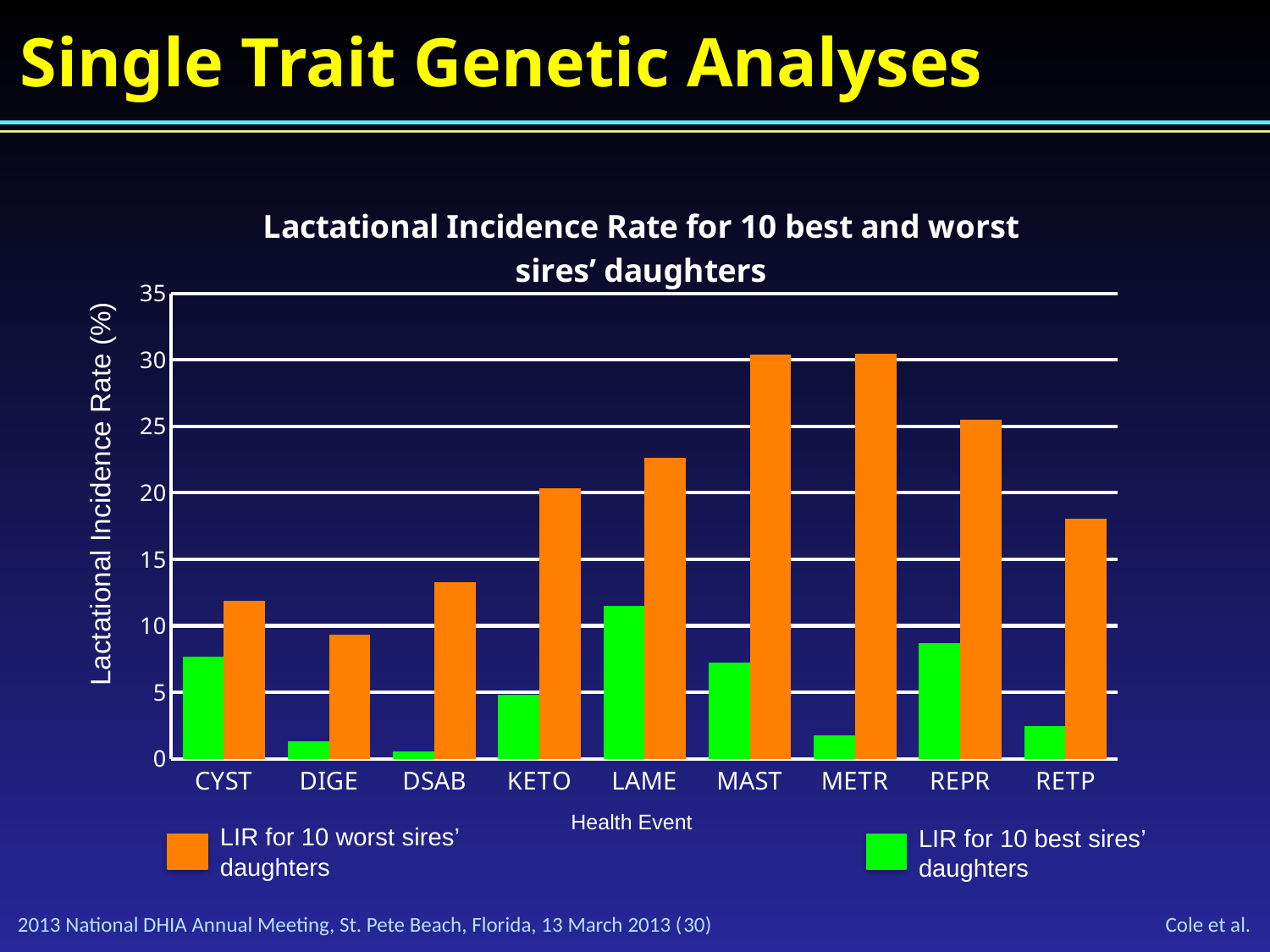
How many series does the legend list? 2 What colour represents LIR for 10 best sires' daughters? green Which health event has the highest value for LIR for 10 best sires' daughters? LAME Is the value for LIR for 10 worst sires' daughters at DSAB greater or less than 15? less Is the value for LIR for 10 best sires' daughters at CYST greater or less than 5? greater What type of chart is shown on the slide? bar chart Which health event has the lowest value for LIR for 10 worst sires' daughters? DIGE Is the value for LIR for 10 worst sires' daughters at RETP greater or less than 20? less How many health event categories are shown on the x axis? 9 Which health event has the lowest value for LIR for 10 best sires' daughters? DSAB Which is larger for LIR for 10 worst sires' daughters: REPR or RETP? REPR